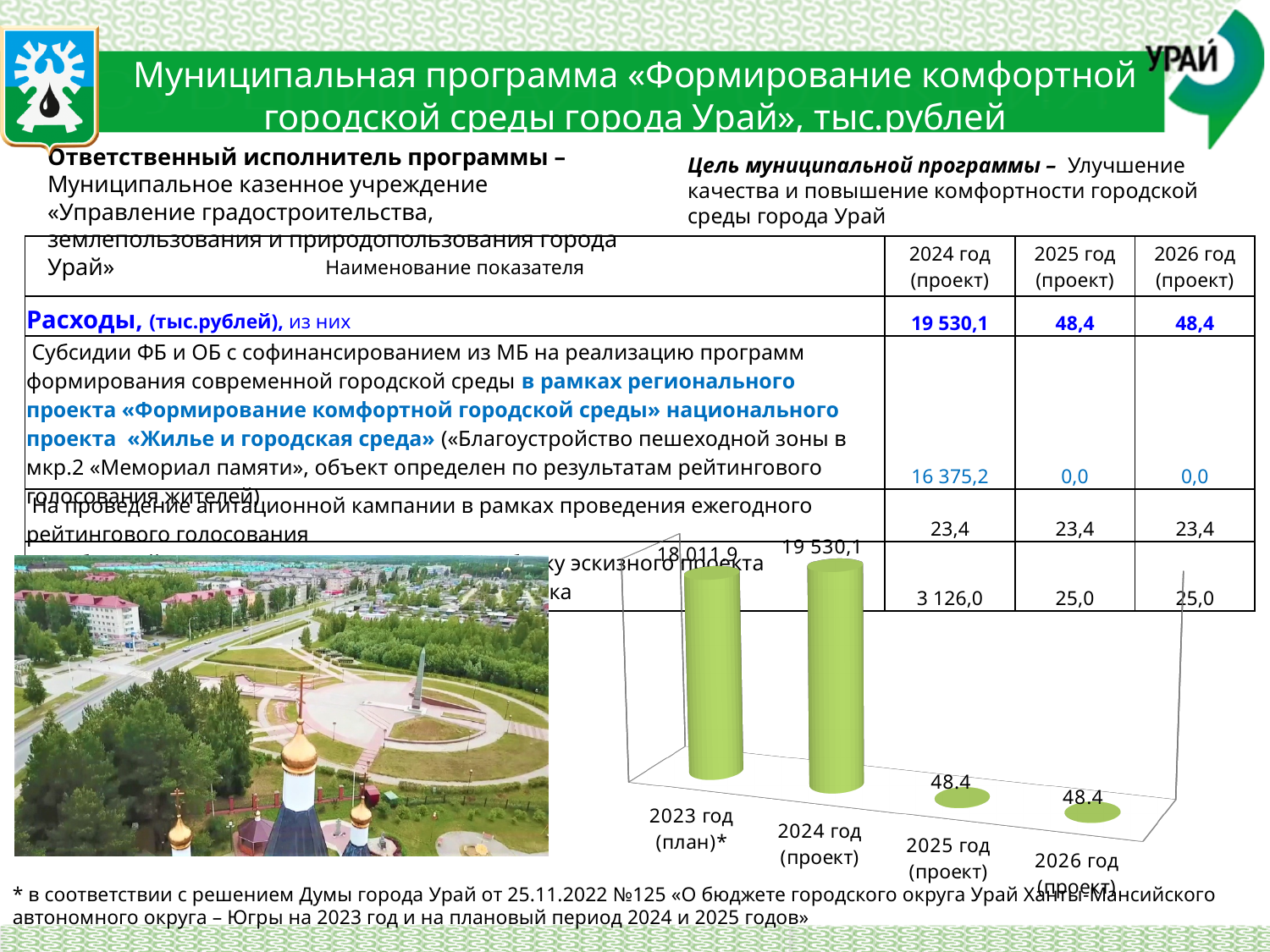
What colour are the bars in the bar chart? green How many categories (years) does the bar chart at the bottom right show? 4 In the bar chart, what is the value for 2024 год (проект)? 19 530,1 In the bar chart, which is larger: the value for 2023 год (план)* or the value for 2025 год (проект)? 2023 год (план)* In the bar chart, what is the difference between the values for 2024 год (проект) and 2023 год (план)*? 1 518,2 In the bar chart, what is the difference between the values for 2024 год (проект) and 2026 год (проект)? 19 481,7 What kind of chart is shown at the bottom right of the slide? bar chart In the bar chart, what is the value for 2025 год (проект)? 48,4 In the bar chart, what is the value for 2026 год (проект)? 48,4 In the bar chart, what is the value for 2023 год (план)*? 18 011,9 In the bar chart, do the values rise or fall from 2024 год (проект) to 2025 год (проект)? fall In the bar chart, which year has the highest value? 2024 год (проект)